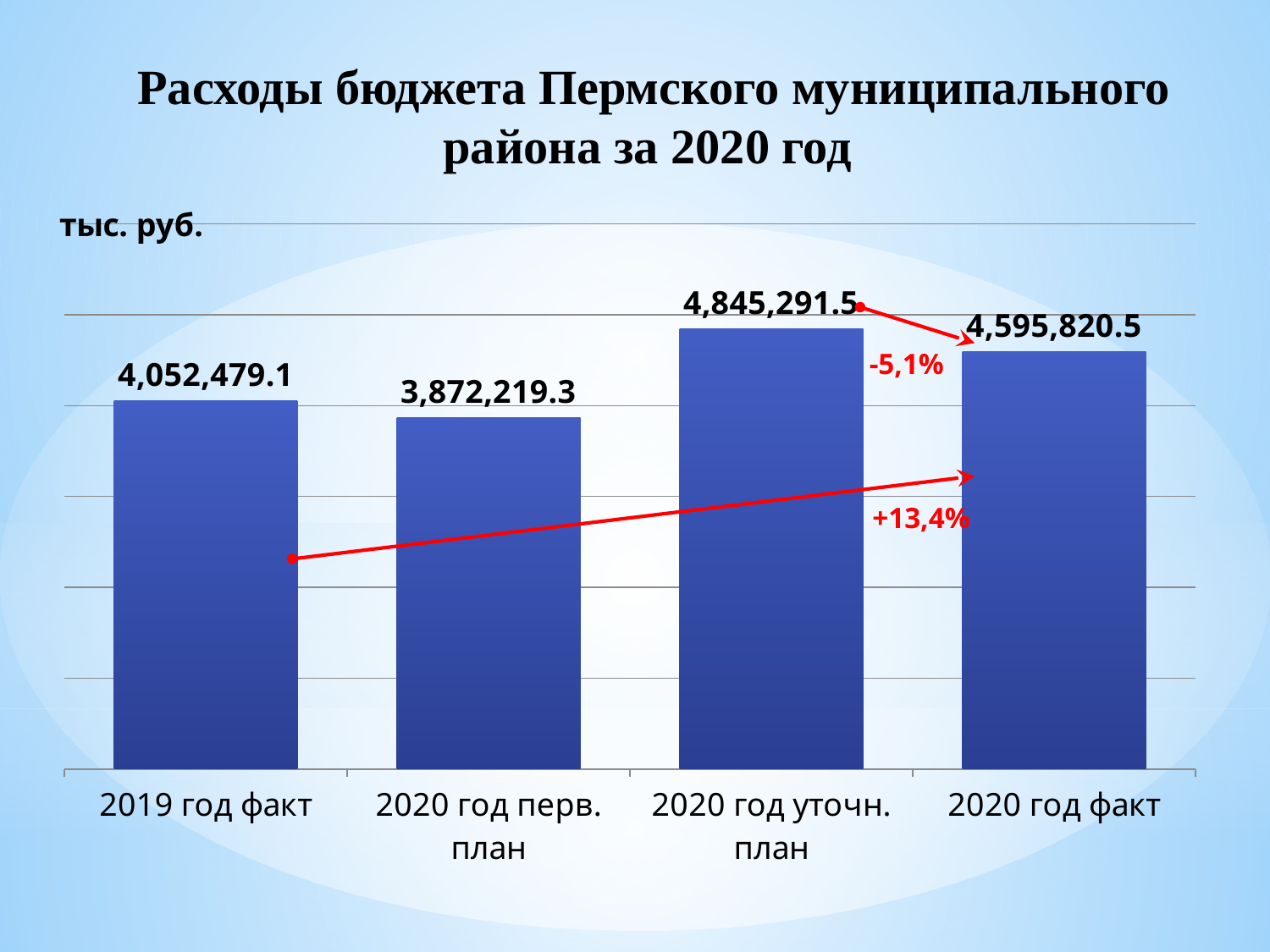
What is the value for 2020 год факт? 4,595,820.5 Which category has the highest value? 2020 год уточн. план What is the difference between the values for 2019 год факт and 2020 год перв. план? 180,259.8 How many categories are shown in the chart? 4 What is the value for 2020 год уточн. план? 4,845,291.5 What is the value for 2019 год факт? 4,052,479.1 What kind of chart is shown on the slide? Bar chart What is the difference between the values for 2020 год уточн. план and 2020 год факт? 249,471.0 Which category has the lowest value? 2020 год перв. план What percentage change is annotated between 2019 год факт and 2020 год факт? +13,4% What is the value for 2020 год перв. план? 3,872,219.3 Which is larger, the value for 2020 год факт or the value for 2019 год факт? 2020 год факт